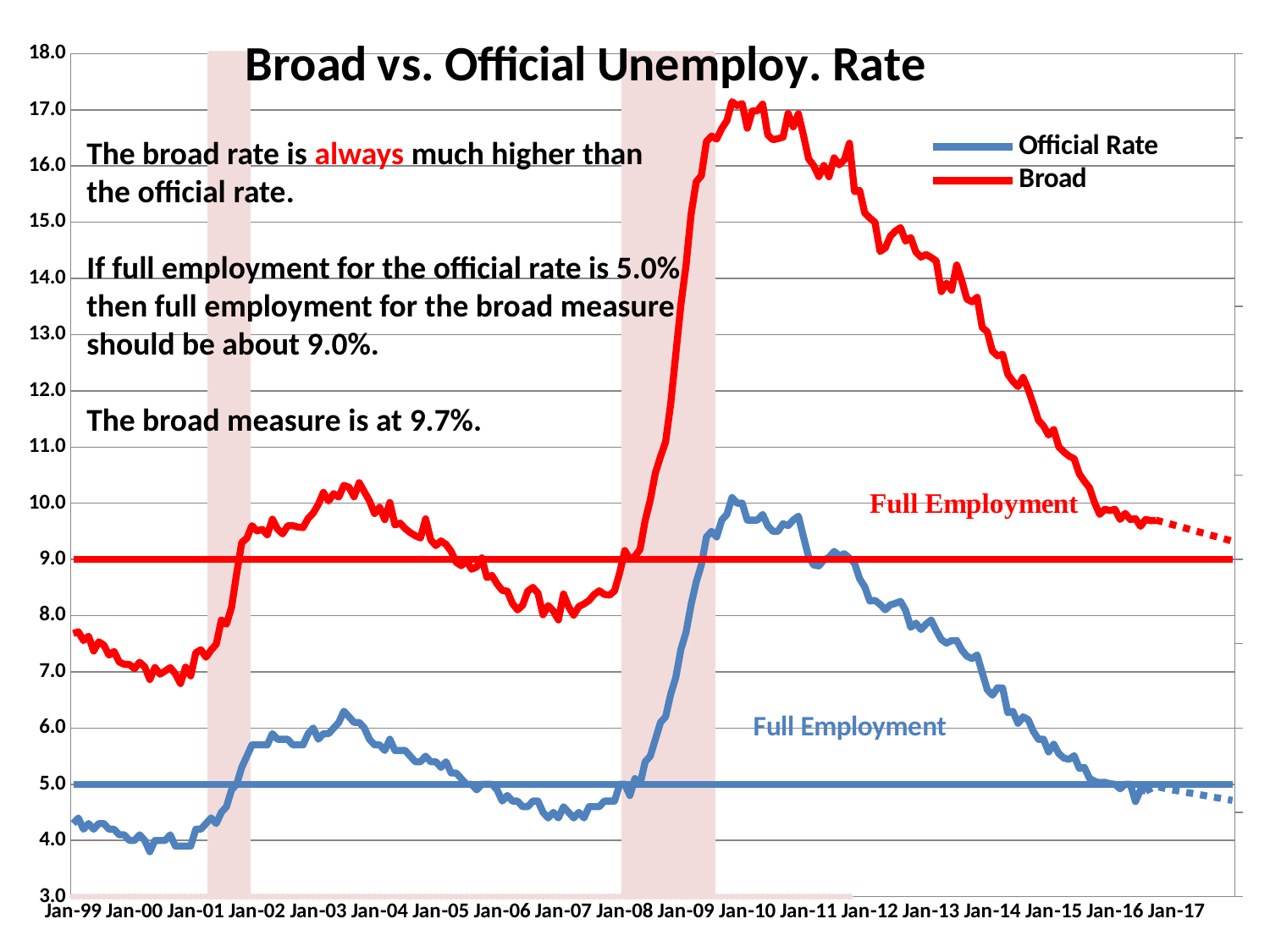
According to the slide text, what is the current value of the broad measure? 9.7% How many series does the legend list? 2 Is the Broad series at Jan-06 greater or less than 9.0? less Is the peak of the Official Rate around Jan-10 greater or less than 9.0? greater Does the Official Rate rise or fall between Jan-07 and Jan-10? rise Is the peak value of the Broad series around Jan-10 greater or less than 16.0? greater What is the title of the chart? Broad vs. Official Unemploy. Rate Does the Broad series rise or fall between Jan-11 and Jan-16? fall Which colour is used for the Broad series? red Around Jan-10, which series is higher, Official Rate or Broad? Broad What kind of chart is shown on the slide? line chart